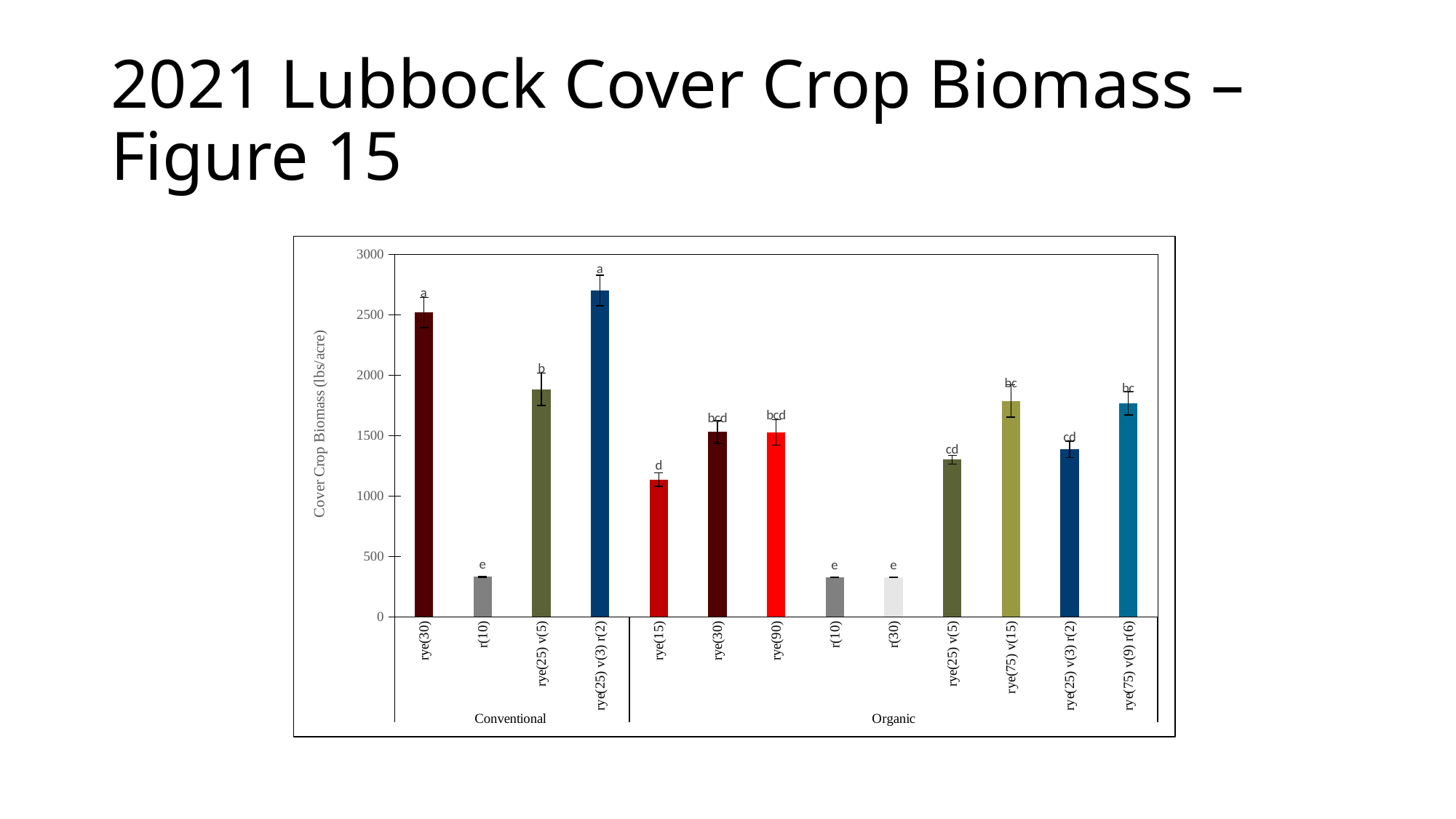
Which is larger, the value for Organic rye(75) v(15) or the value for Organic rye(25) v(5)? rye(75) v(15) Is the value for Organic r(10) greater or less than 500? less What letter is printed above the Conventional rye(25) v(5) bar? b Is the value for Conventional rye(25) v(5) greater or less than 2000? less Which treatment has the highest cover crop biomass in the chart? rye(25) v(3) r(2) (Conventional) What is the label on the y axis of the chart? Cover Crop Biomass (lbs/acre) How many bars are plotted in the chart? 13 What kind of chart is shown on the slide? bar chart How many bars are in the Conventional group? 4 How many bars are in the Organic group? 9 Is the value for Organic rye(15) greater or less than 1000? greater